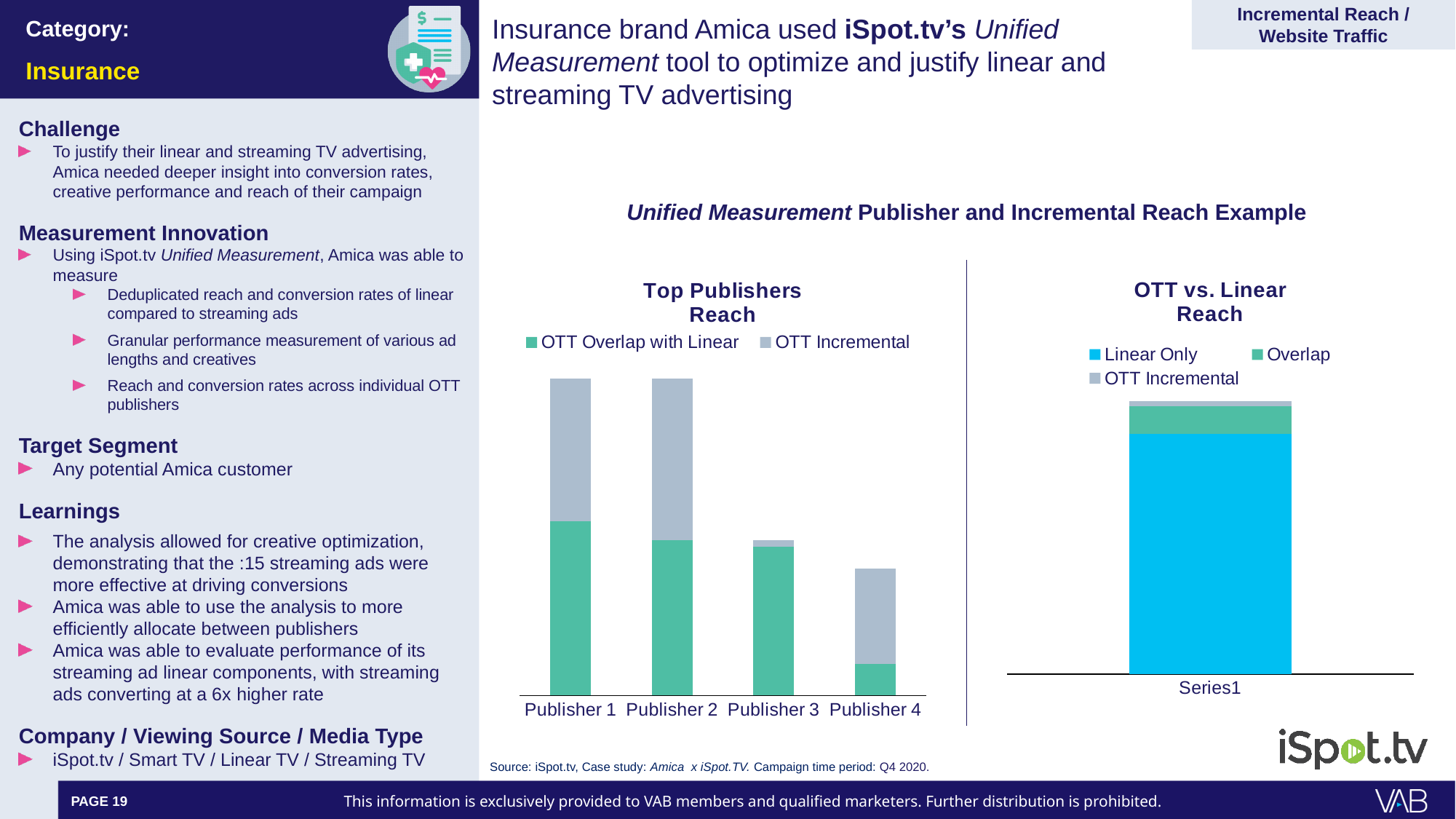
How many series does the legend of the "OTT vs. Linear Reach" chart list? 3 In the "Top Publishers Reach" chart, which publisher has the largest OTT Overlap with Linear segment? Publisher 1 How many publishers are shown on the x axis of the "Top Publishers Reach" chart? 4 What type of chart is the "Top Publishers Reach" chart? Stacked bar chart In the "Top Publishers Reach" chart, is the total bar for Publisher 3 or Publisher 4 taller? Publisher 3 How many series does the legend of the "Top Publishers Reach" chart list? 2 In the "Top Publishers Reach" chart, which publisher has the smallest OTT Incremental segment? Publisher 3 In the "Top Publishers Reach" chart, which publisher has the largest OTT Incremental segment? Publisher 2 In the "Top Publishers Reach" chart, which series is shown in green? OTT Overlap with Linear In the "OTT vs. Linear Reach" chart, which series makes up the smallest segment of the bar? OTT Incremental In the "OTT vs. Linear Reach" chart, which series makes up the largest segment of the bar? Linear Only In the "Top Publishers Reach" chart, which publisher has the lowest total reach? Publisher 4